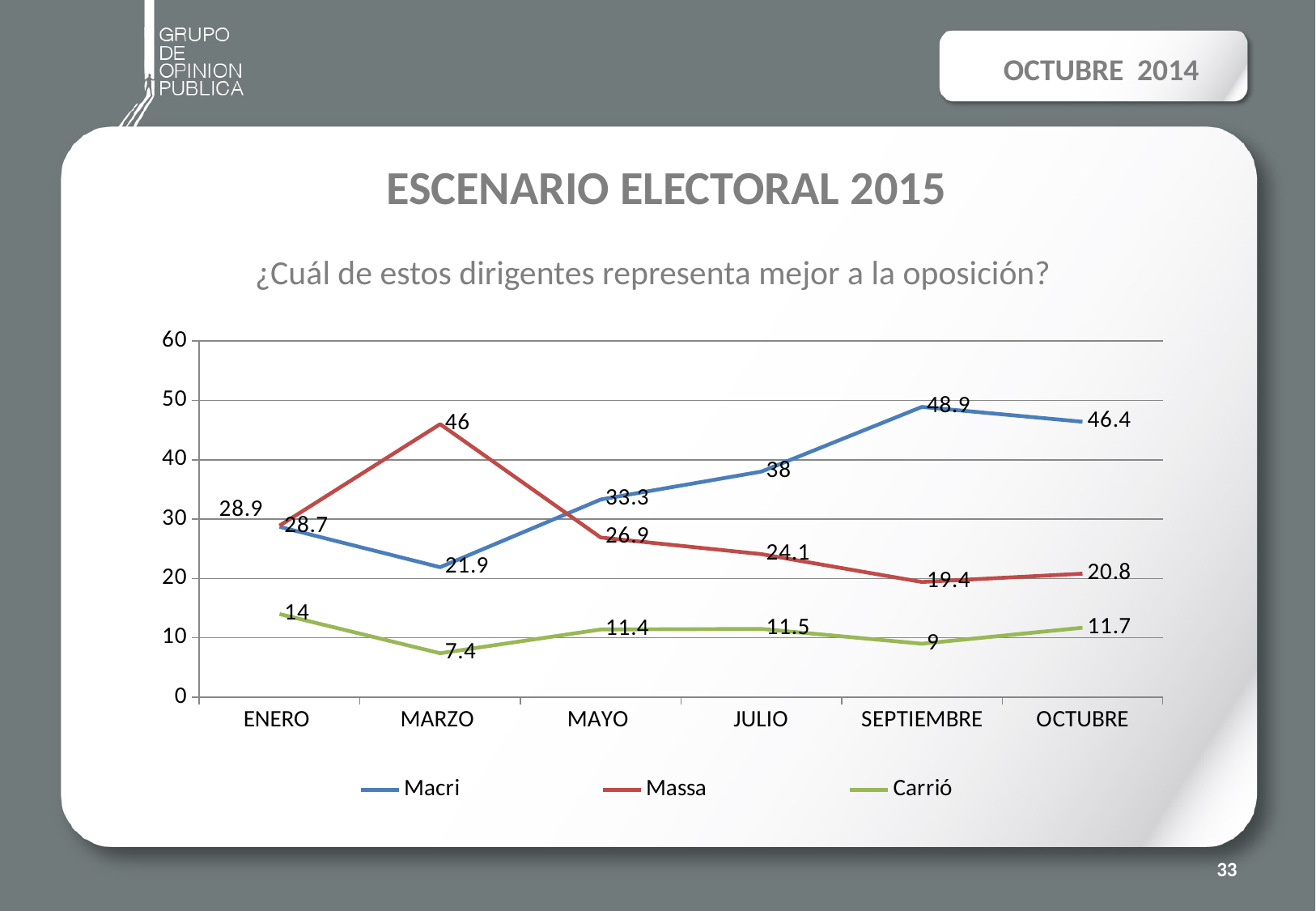
In which month does Macri reach his highest value? SEPTIEMBRE What value does Macri have in SEPTIEMBRE? 48.9 Does Massa's value rise or fall from MARZO to SEPTIEMBRE? fall What value does Massa have in MARZO? 46 What value does Carrió have in MARZO? 7.4 What is the difference between Macri's and Massa's values in OCTUBRE? 25.6 How many series does the legend list? 3 In MAYO, who has the higher value, Macri or Massa? Macri Is Massa's value in SEPTIEMBRE greater or less than 20? less In which month does Carrió have her lowest value? MARZO What kind of chart is shown on the slide? line chart How many months are shown on the x axis? 6